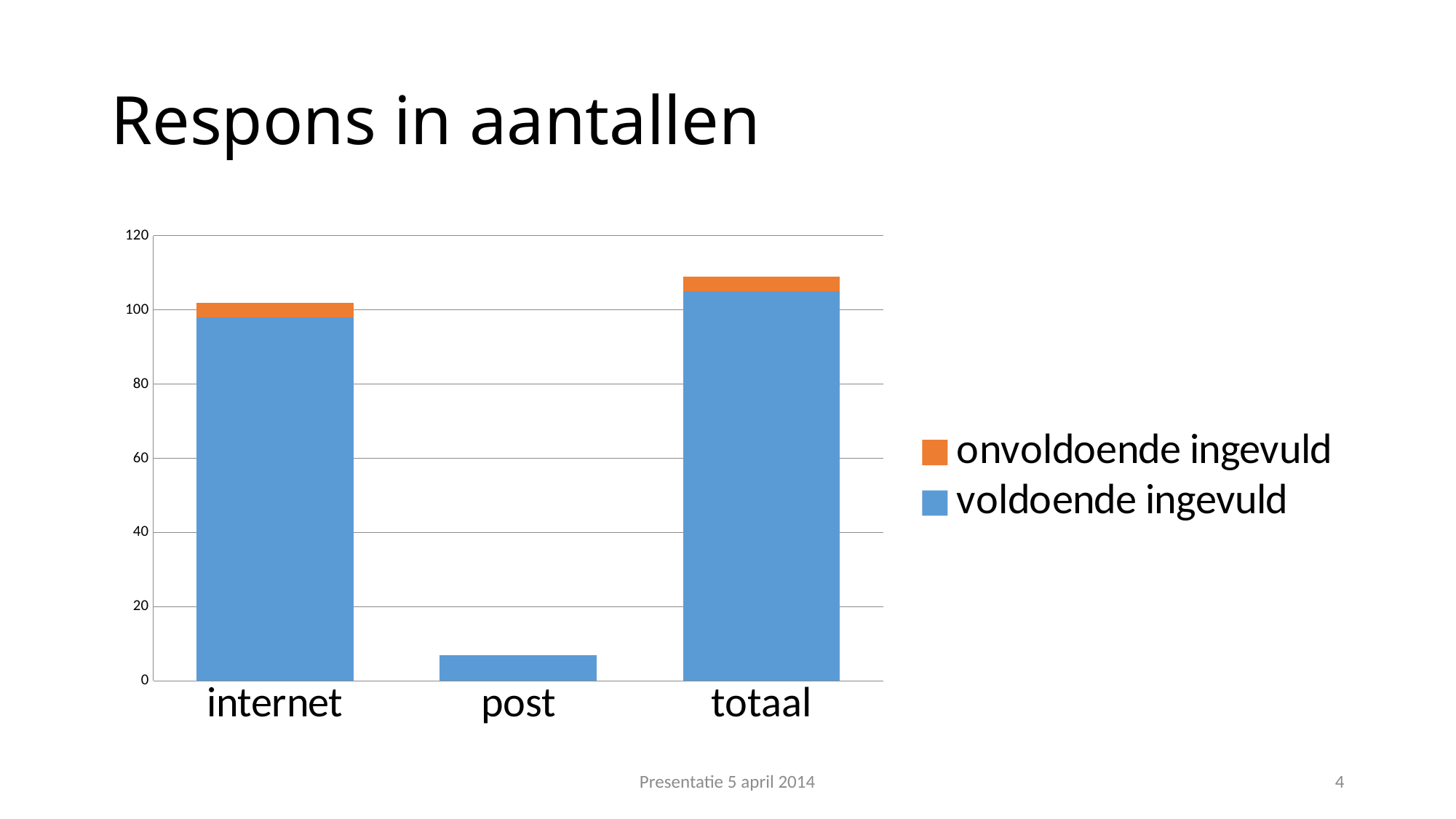
Is the total value for totaal greater or less than 120? less Is the value for post greater or less than 20? less Which colour represents 'onvoldoende ingevuld' in the chart? orange What kind of chart is shown on the slide? bar chart Is the total value for internet greater or less than 100? greater Which category has the highest total bar? totaal How many series does the legend list? 2 Which category has the lowest total bar? post What is the title of the slide containing the chart? Respons in aantallen How many categories are shown on the x axis of the chart? 3 Which is larger, the total bar for internet or the total bar for post? internet